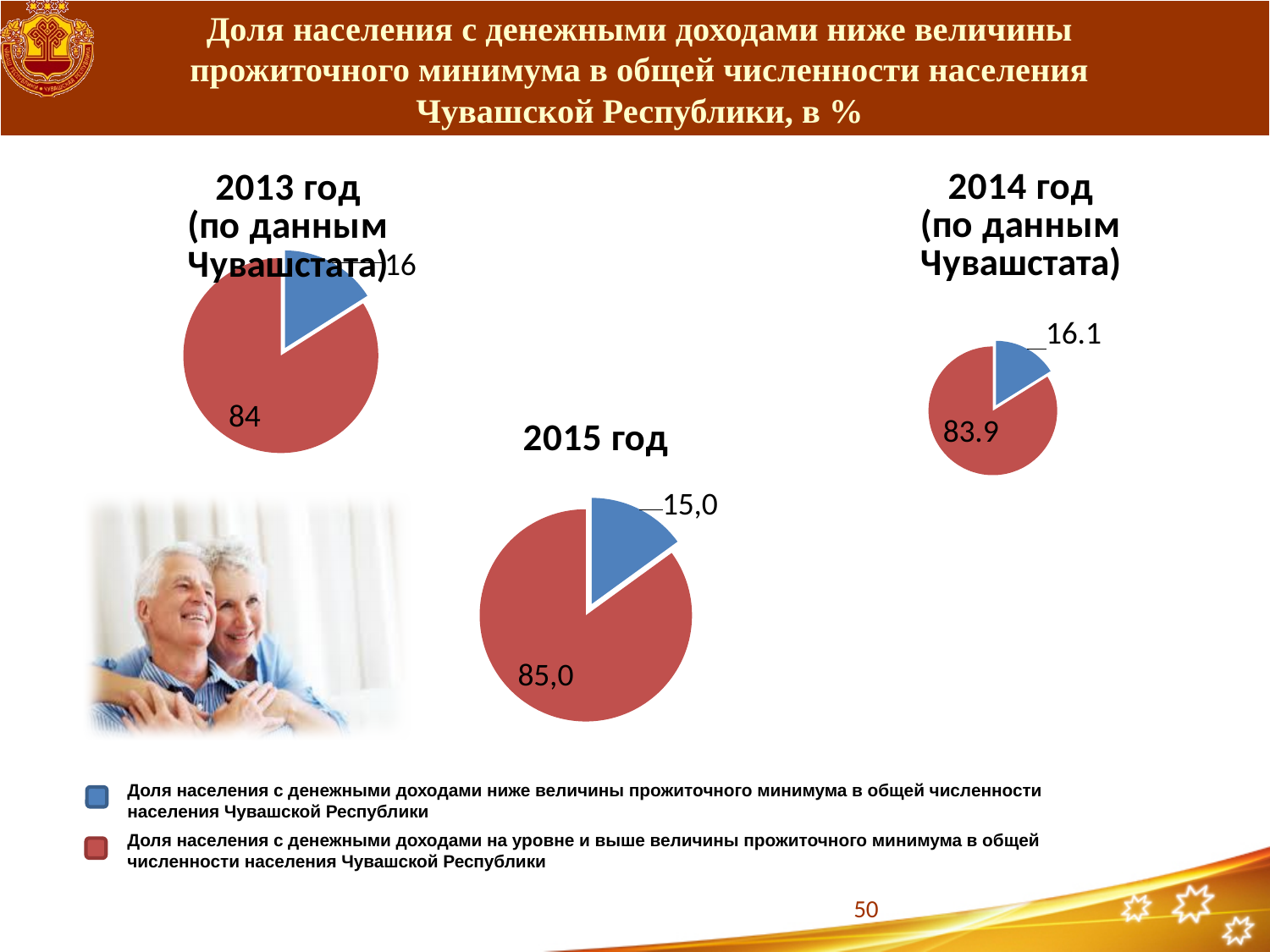
According to the legend, what does the blue colour represent in the pie charts? Доля населения с денежными доходами ниже величины прожиточного минимума в общей численности населения Чувашской Республики In the 2013 год pie chart, what is the difference between the red slice value and the blue slice value? 68 How many slices does the 2014 год pie chart have? 2 In the 2013 год pie chart, what value is shown for the red slice (share of population with incomes at or above the subsistence minimum)? 84 In the 2015 год pie chart, which slice is larger, the blue one or the red one? the red one What kind of chart is used for the 2013 год data on the slide? pie chart In the 2014 год pie chart, what value is shown for the red slice? 83.9 In the 2015 год pie chart, what value is shown for the blue slice? 15,0 How many pie charts are shown on the slide? 3 In the 2013 год pie chart, what value is shown for the blue slice (share of population with incomes below the subsistence minimum)? 16 In the 2015 год pie chart, what value is shown for the red slice? 85,0 In the 2014 год pie chart, what value is shown for the blue slice? 16.1